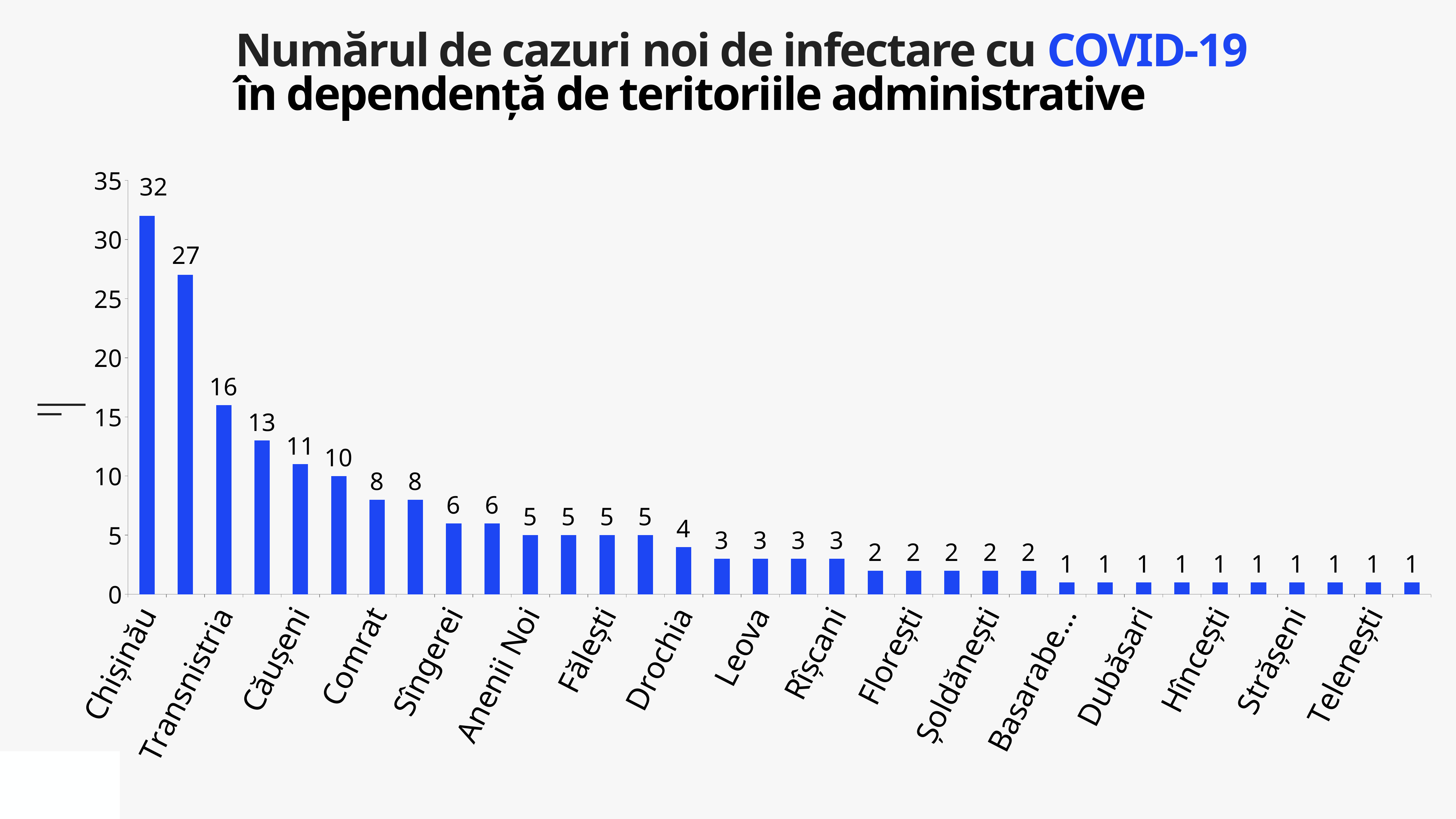
Which is larger, the value for Căușeni or the value for Comrat? Căușeni Do the values rise or fall from left to right along the x axis? fall Which territory has the highest number of new cases? Chișinău What is the value for Drochia? 4 What is the value for Transnistria? 16 What is the difference between the values for Chișinău and Transnistria? 16 What is the value for Chișinău? 32 What kind of chart is shown on the slide? bar chart What is the value for Căușeni? 11 What is the value for Comrat? 8 Which words in the chart title are shown in blue? COVID-19 Is the value for Chișinău greater or less than 30? greater